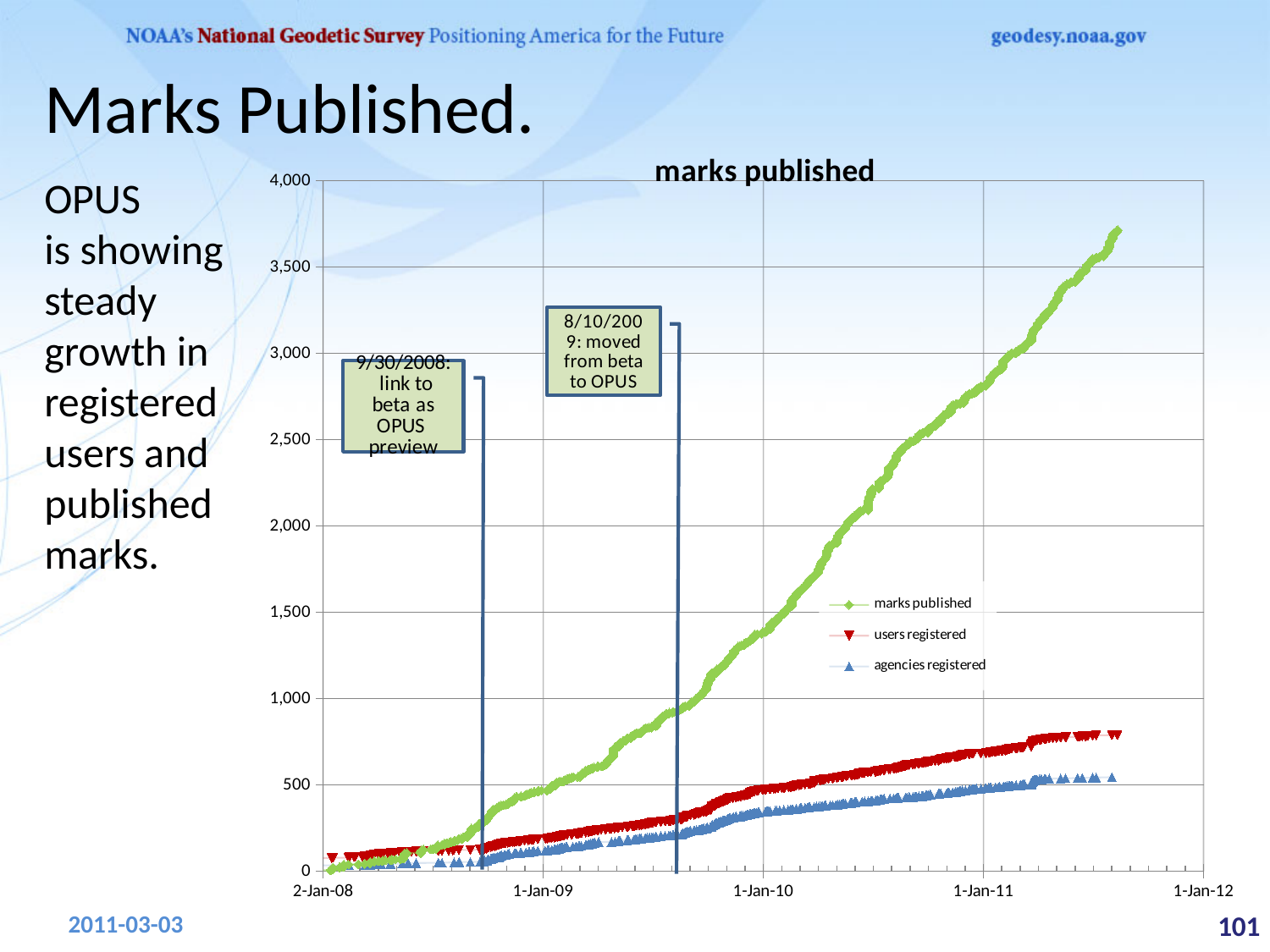
Which series has the lowest values at the right end of the chart? agencies registered What is the title of the chart? marks published Is the value for marks published at 1-Jan-11 greater or less than 2,500? greater Is the value for users registered at 1-Jan-11 greater or less than 500? greater Do the values for marks published rise or fall over time along the x axis? rise Which series reaches the highest value by the end of the chart? marks published Is the value for marks published at 1-Jan-10 greater or less than 1,000? greater What event does the annotation box dated 8/10/2009 describe? moved from beta to OPUS What kind of chart is shown on the slide? line chart How many series does the chart legend list? 3 At 1-Jan-11, which is larger: users registered or agencies registered? users registered